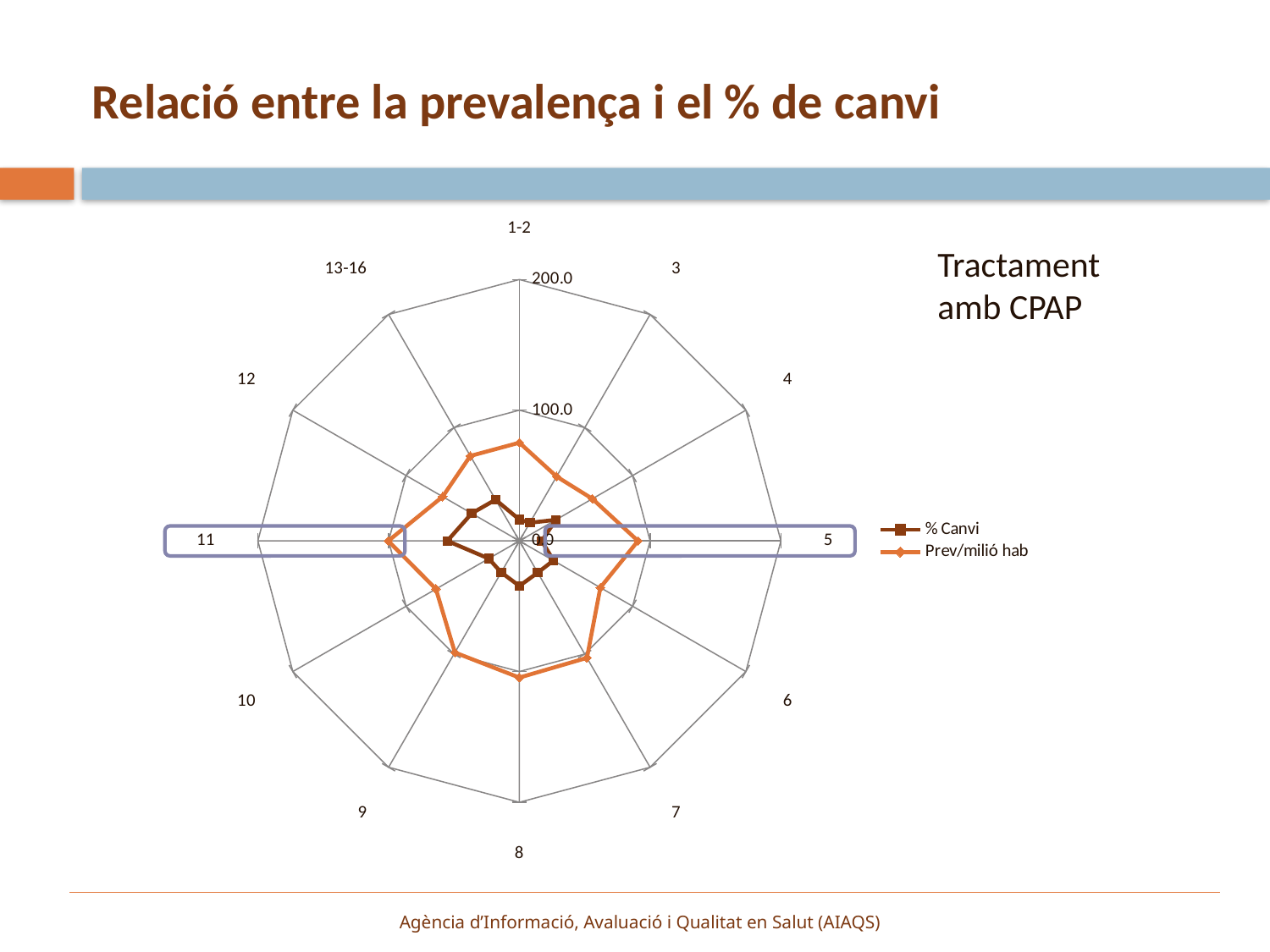
Is the Prev/milió hab value for category 1-2 greater or less than 100.0? less Which category has the larger Prev/milió hab value, 7 or 3? 7 Which category has the larger % Canvi value, 11 or 5? 11 Is the Prev/milió hab value for category 3 greater or less than 100.0? less How many categories are plotted around the radar chart? 12 How many series does the chart's legend list? 2 Is the % Canvi value for category 11 greater or less than 100.0? less What kind of chart is shown on the slide? Radar chart What are the two series named in the legend? % Canvi and Prev/milió hab What is the title of the slide containing the chart? Relació entre la prevalença i el % de canvi For category 1-2, which series has the larger value, % Canvi or Prev/milió hab? Prev/milió hab